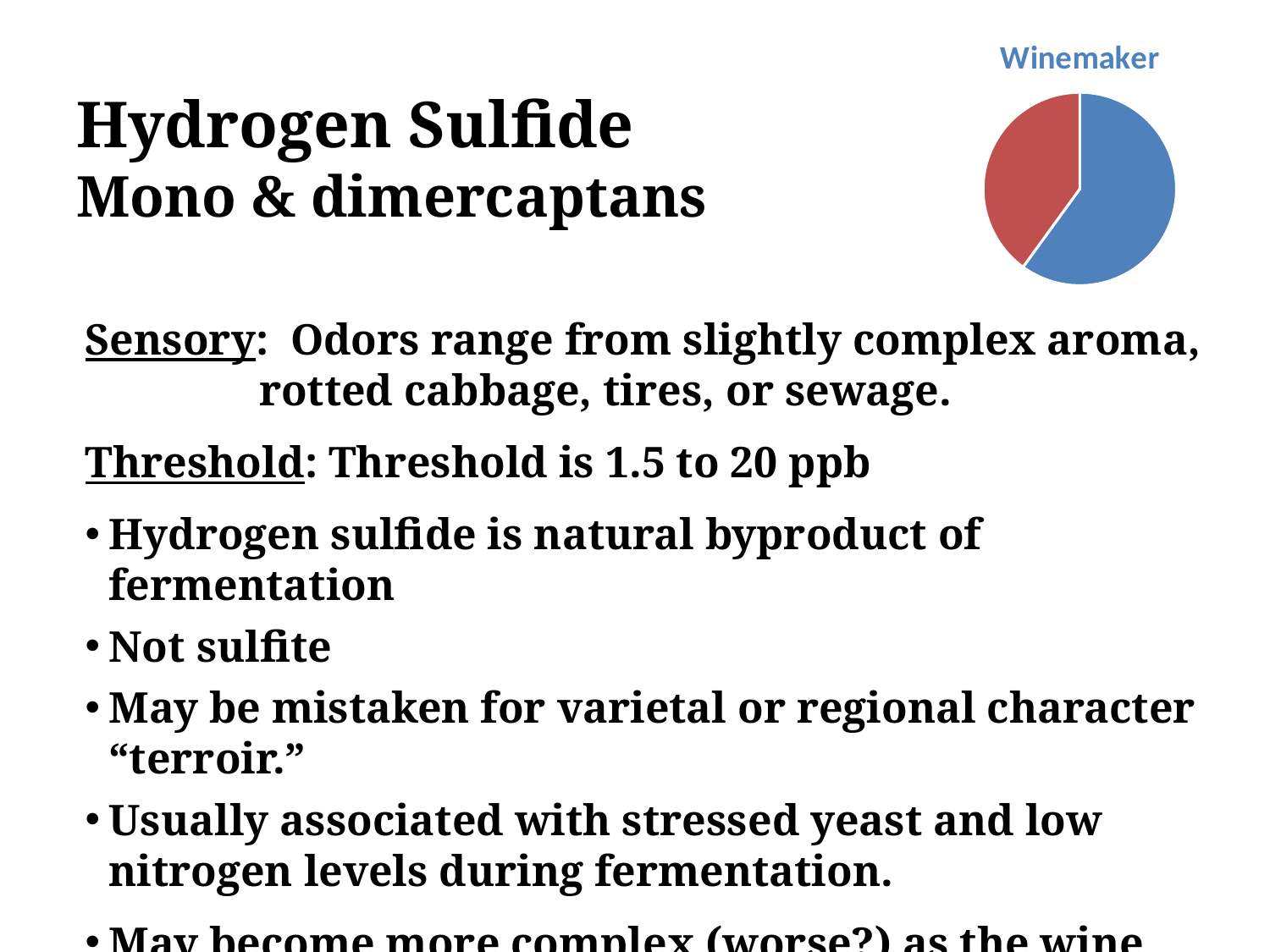
What two colours are used for the slices of the pie chart? blue and red Which colour slice is the smallest in the pie chart? red What is the title of the chart on the slide? Winemaker What kind of chart is shown on the slide? pie chart Which slice of the pie chart is larger, the blue one or the red one? blue How many slices does the pie chart have? 2 Which colour slice is the largest in the pie chart? blue